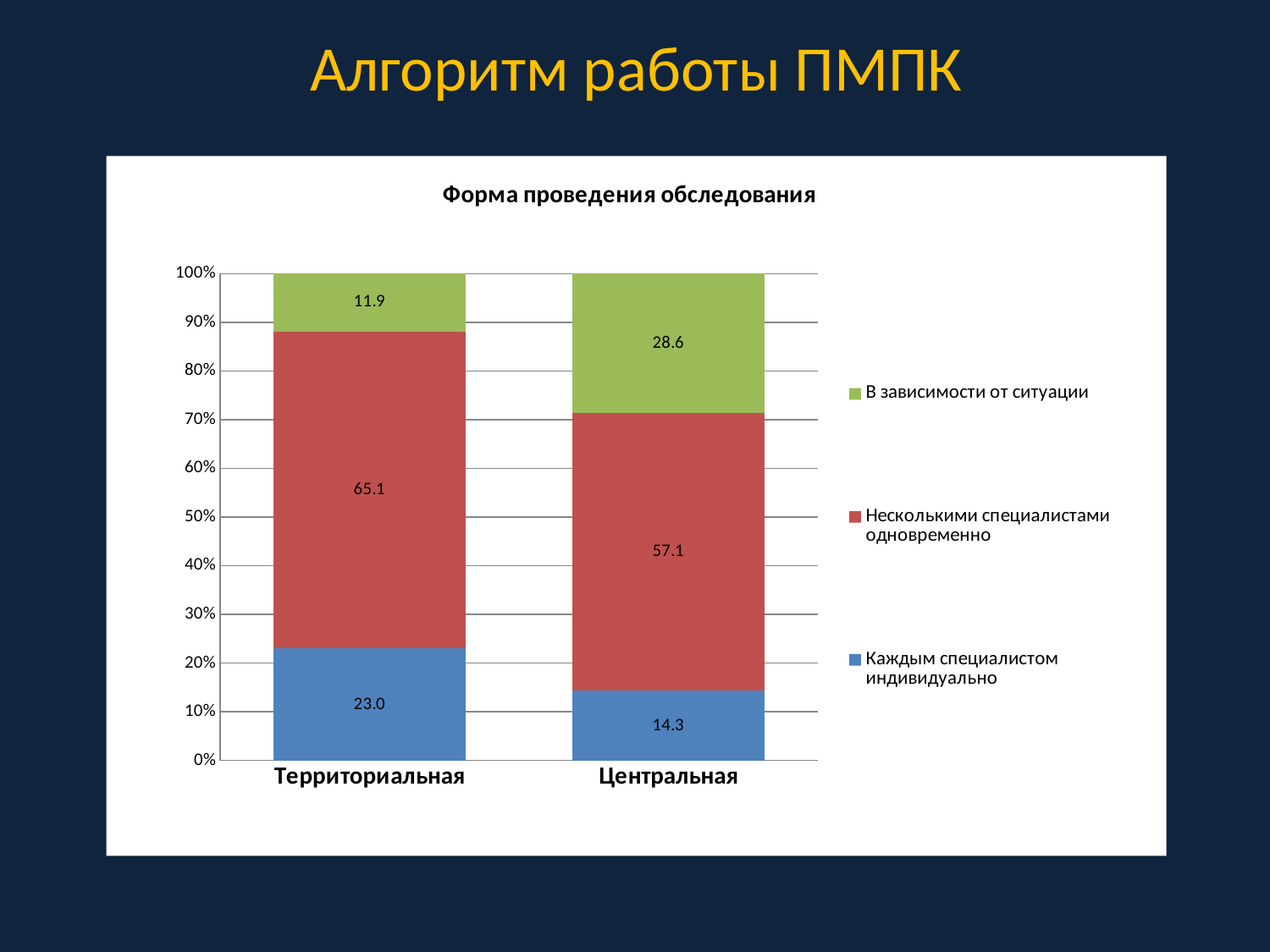
How many series does the legend list? 3 Which series has the smallest value in the Центральная bar? Каждым специалистом индивидуально What is the value for "Несколькими специалистами одновременно" in the Центральная bar? 57.1 How many categories are shown on the x axis? 2 What is the difference between the "В зависимости от ситуации" values for Центральная and Территориальная? 16.7 What is the title of the chart? Форма проведения обследования What is the value for "Каждым специалистом индивидуально" in the Территориальная bar? 23.0 What is the difference between the "Несколькими специалистами одновременно" values for Территориальная and Центральная? 8.0 Which series has the largest value in the Территориальная bar? Несколькими специалистами одновременно Which category has the higher value for "В зависимости от ситуации"? Центральная What is the value for "Каждым специалистом индивидуально" in the Центральная bar? 14.3 What is the value for "В зависимости от ситуации" in the Территориальная bar? 11.9